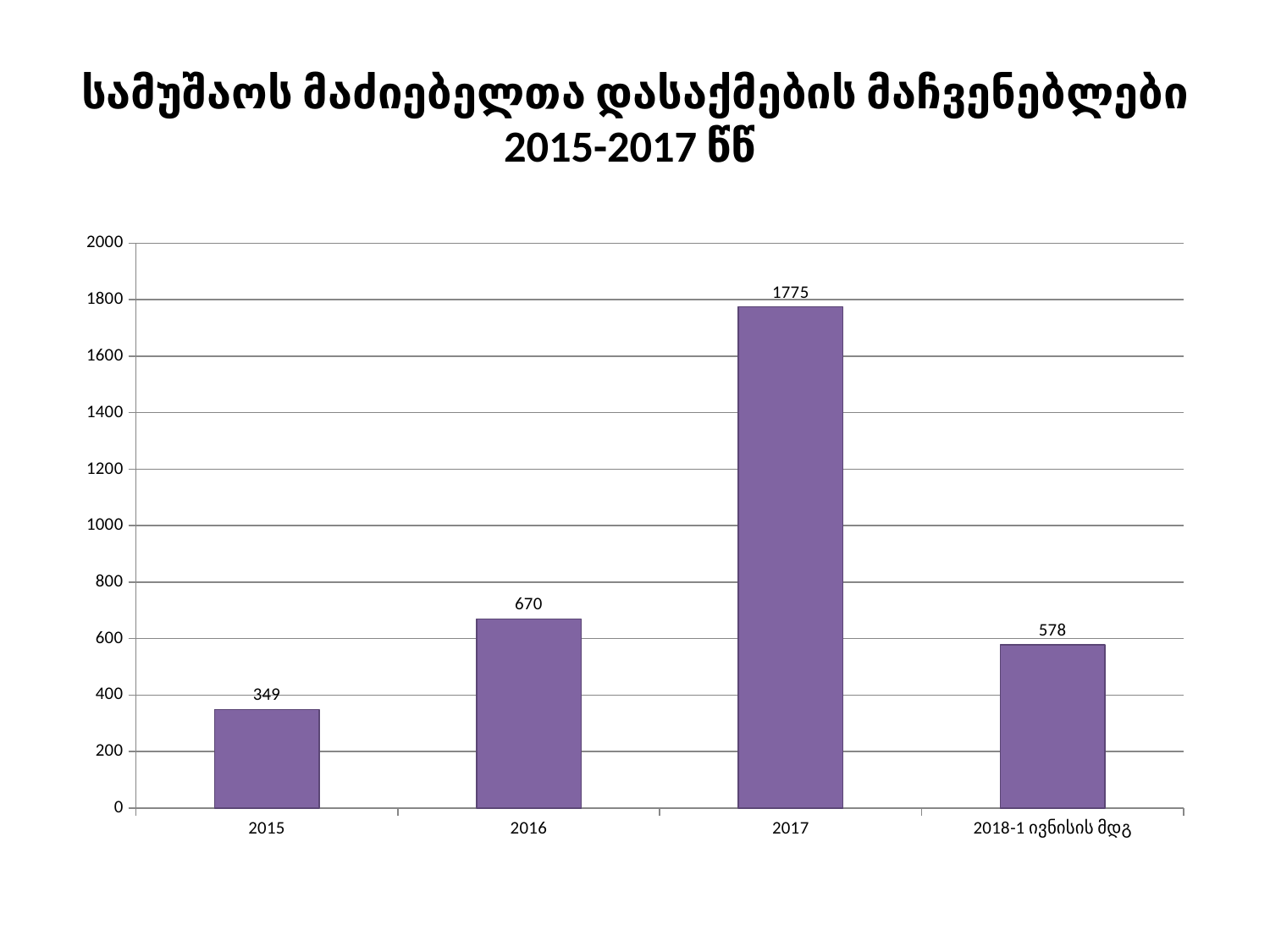
What is the value for 2015? 349 What is the difference between the values for 2016 and 2015? 321 Which category has the highest value? 2017 How many categories are shown on the x axis? 4 What is the difference between the values for 2017 and 2016? 1105 What kind of chart is shown on the slide? bar chart Which is larger, the value for 2016 or the value for 2018-1 ივნისის მდე? 2016 Do the values rise or fall from 2015 to 2017? rise Which category has the lowest value? 2015 What is the value for 2016? 670 What is the value for 2017? 1775 What is the value for the category labelled 2018-1 ივნისის მდე? 578